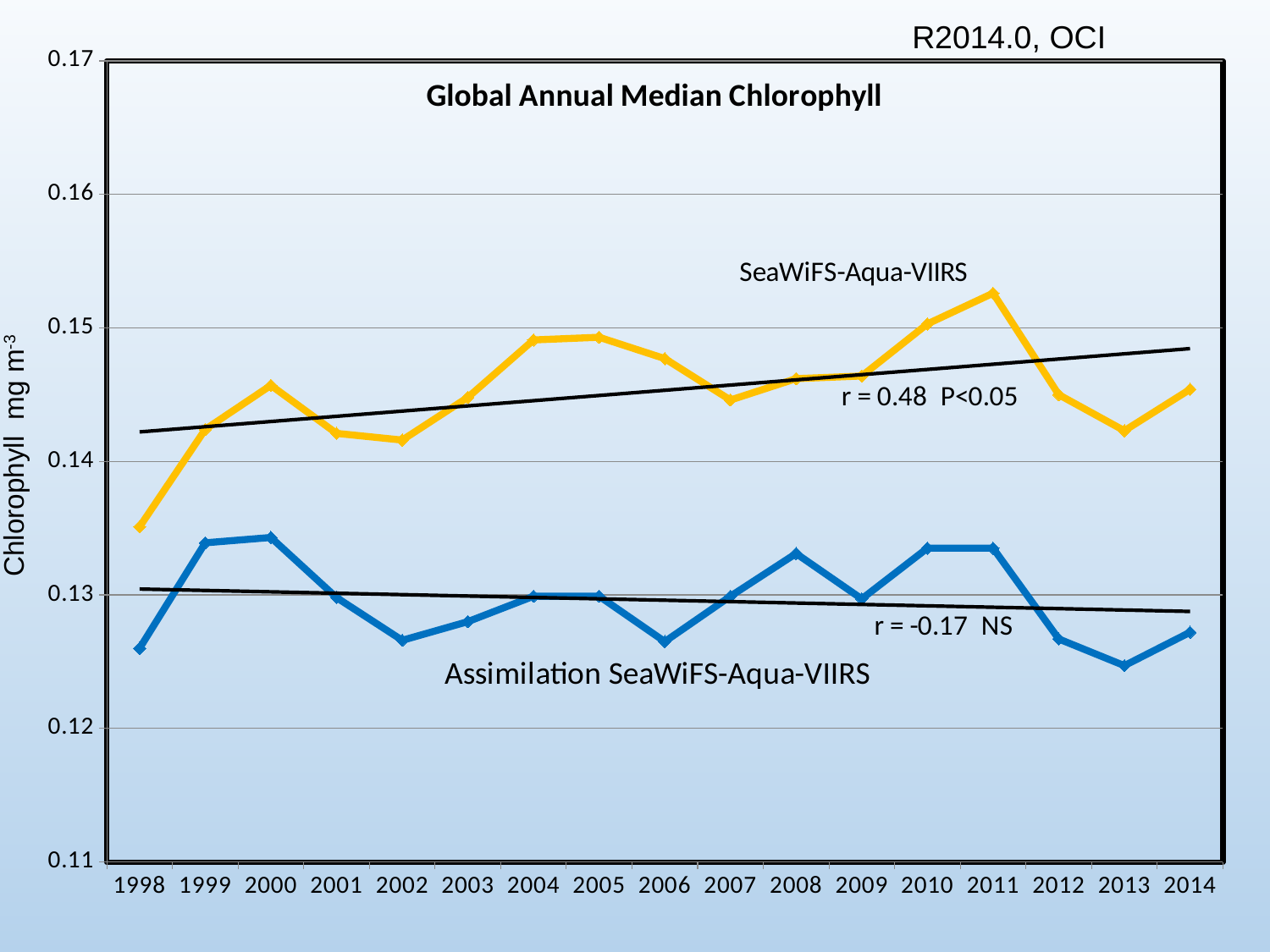
What is the title of the chart? Global Annual Median Chlorophyll What type of chart is shown on the slide? line chart Is the SeaWiFS-Aqua-VIIRS value for 2011 greater or less than 0.15? greater In which year does the SeaWiFS-Aqua-VIIRS series have its lowest value? 1998 In which year does the SeaWiFS-Aqua-VIIRS series reach its highest value? 2011 Which is larger for the Assimilation SeaWiFS-Aqua-VIIRS series, the value for 2000 or the value for 2002? 2000 According to the fitted trend line, does the SeaWiFS-Aqua-VIIRS series rise or fall from 1998 to 2014? rise In which year does the Assimilation SeaWiFS-Aqua-VIIRS series have its lowest value? 2013 Is the SeaWiFS-Aqua-VIIRS value for 1998 greater or less than 0.14? less How many years are shown along the x axis? 17 How many data series are plotted on the chart? 2 Is the Assimilation SeaWiFS-Aqua-VIIRS value for 2008 greater or less than 0.13? greater